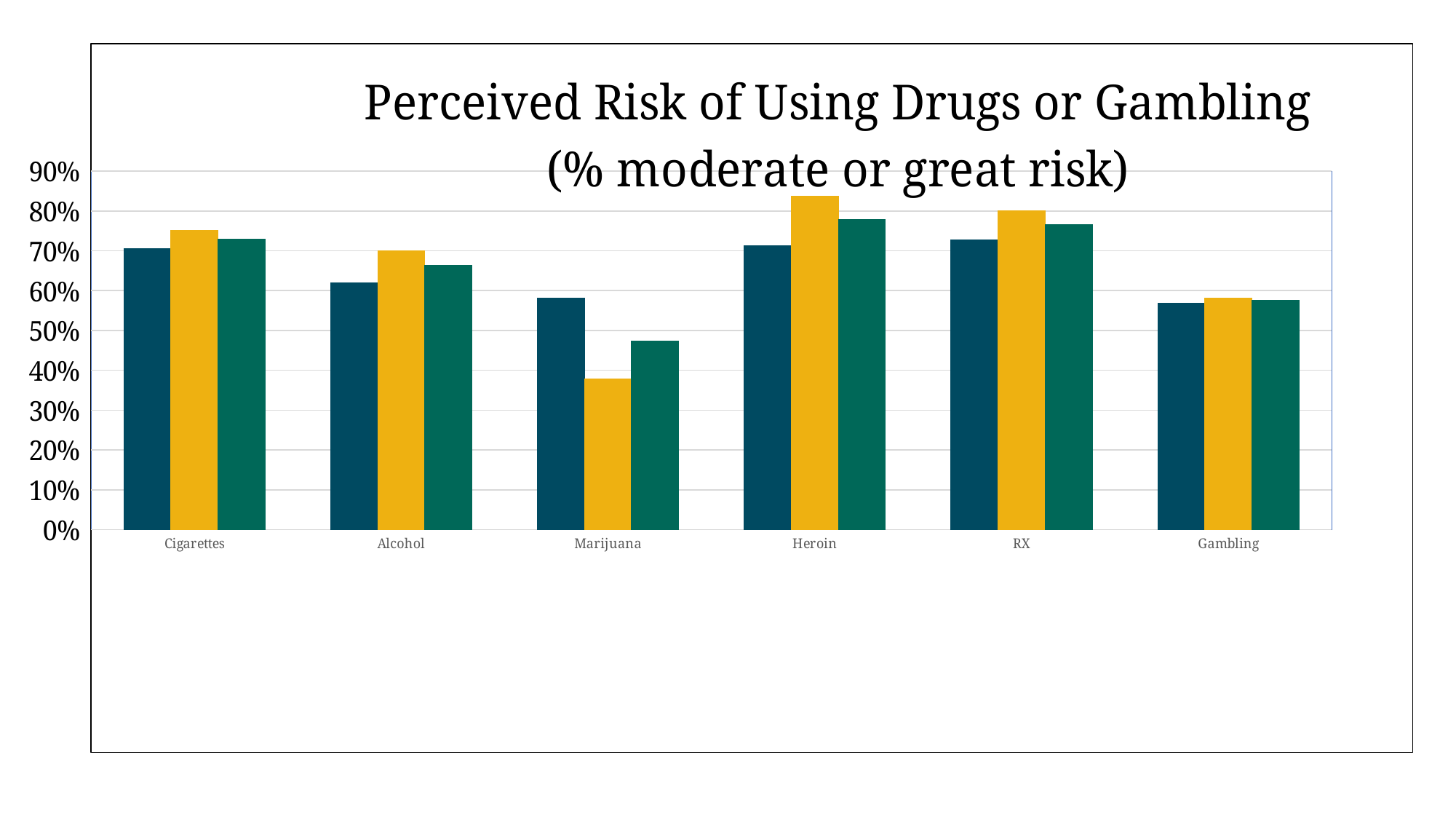
What kind of chart is shown on the slide? bar chart Is the value of the green bar for Marijuana greater or less than 50%? less Is the value of the yellow bar for Marijuana greater or less than 40%? less Which category has the lowest green bar? Marijuana Is the value of the yellow bar for Heroin greater or less than 80%? greater How many categories are shown on the x axis of the chart? 6 Which category has the highest yellow bar? Heroin What is the title of the chart? Perceived Risk of Using Drugs or Gambling (% moderate or great risk) For Marijuana, which is larger: the yellow bar or the green bar? the green bar How many bars are plotted for each category in the chart? 3